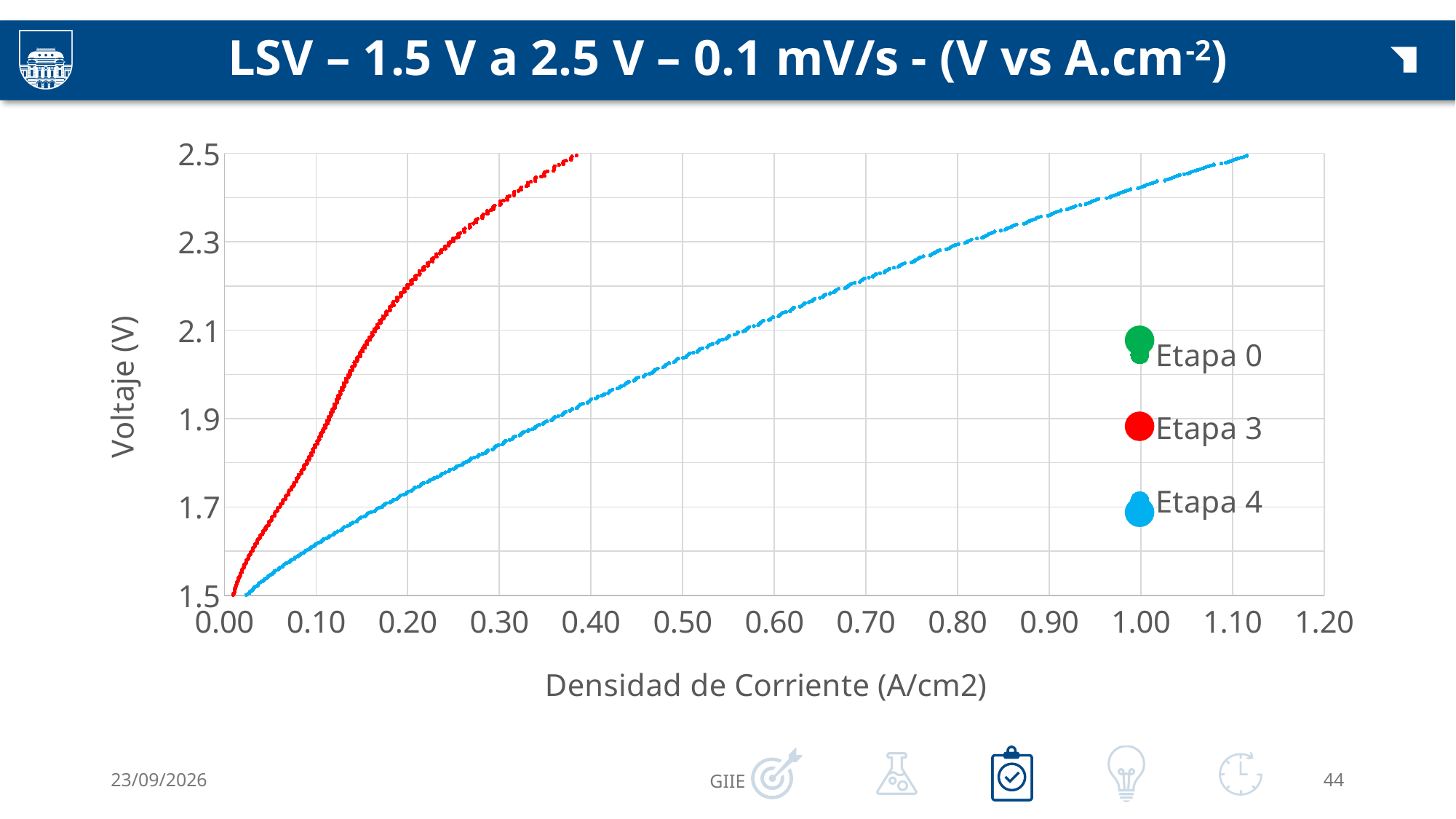
What kind of chart is shown on the slide? scatter chart Is the voltage for Etapa 4 at 1.00 A/cm2 greater or less than 2.3 V? greater Which series reaches 2.5 V at the lowest current density? Etapa 3 How many series does the legend list? 3 What is the title of the x axis? Densidad de Corriente (A/cm2) Does the voltage for Etapa 3 rise or fall as current density increases? rise Which series reaches the highest current density on the chart? Etapa 4 At a current density of 0.20 A/cm2, which series has the higher voltage, Etapa 3 or Etapa 4? Etapa 3 What is the title of the y axis? Voltaje (V) Does the voltage for Etapa 4 rise or fall as current density increases? rise Is the voltage for Etapa 3 at 0.30 A/cm2 greater or less than 2.3 V? greater Is the voltage for Etapa 4 at 0.70 A/cm2 greater or less than 2.3 V? less